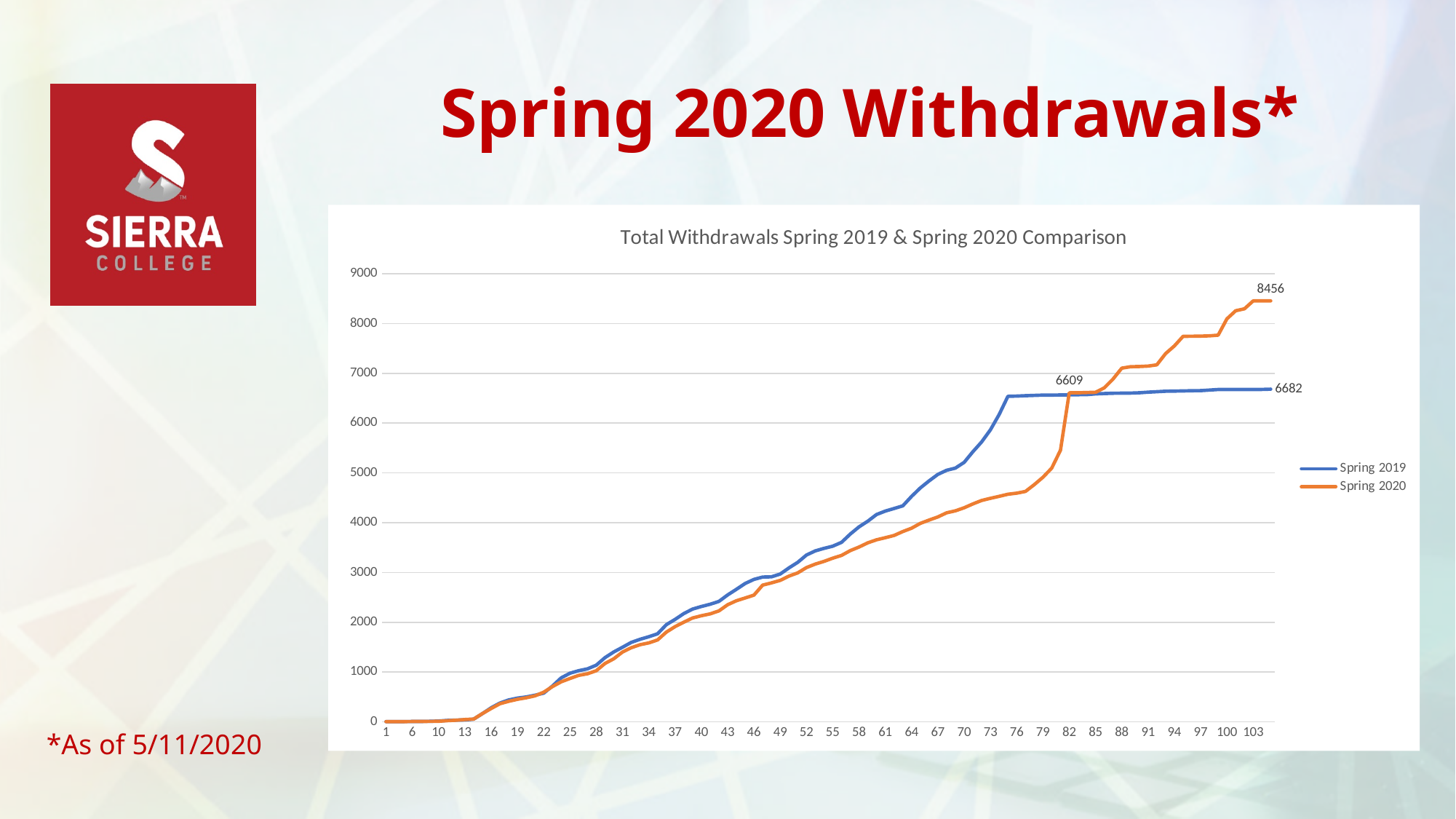
What kind of chart is shown on the slide? line chart What is the difference between the final labelled values of Spring 2020 (8456) and Spring 2019 (6682)? 1774 Is the value for Spring 2019 at point 76 greater or less than 6000? greater What colour is the Spring 2020 line? orange What is the title of the chart? Total Withdrawals Spring 2019 & Spring 2020 Comparison Do the values of the Spring 2020 line rise or fall along the x axis? rise What is the final labelled value of the Spring 2019 line? 6682 What is the final labelled value of the Spring 2020 line? 8456 Is the value for Spring 2020 at point 76 greater or less than 5000? less How many series does the legend list? 2 What is the labelled value on the Spring 2020 line at around point 82? 6609 Which series ends at a higher value, Spring 2019 or Spring 2020? Spring 2020